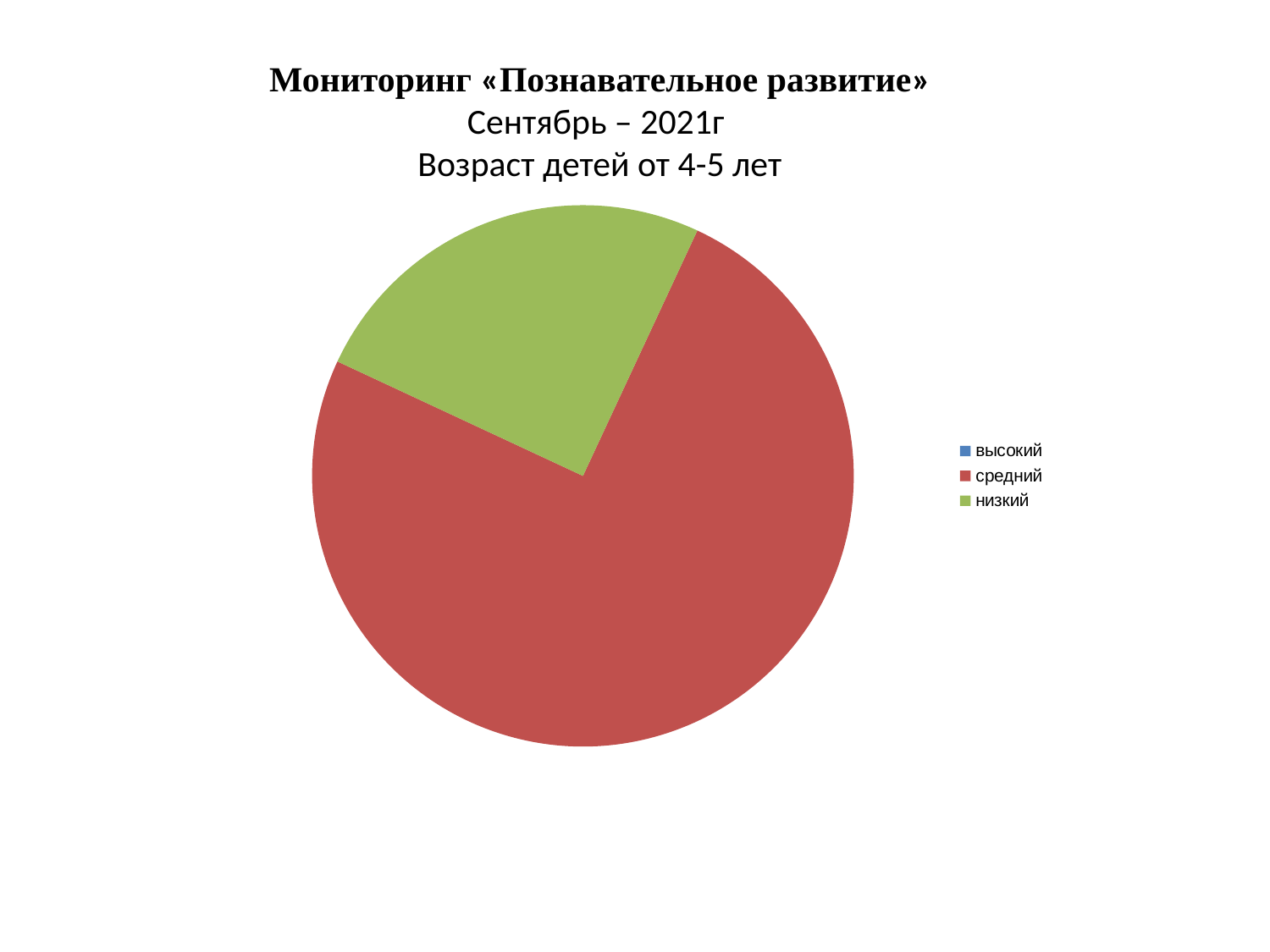
Which category has the largest slice of the pie? средний Is the slice for средний larger or smaller than the slice for низкий? larger Which of the visible slices is smaller, средний or низкий? низкий How many entries does the legend list? 3 How many slices are visible in the pie? 2 What kind of chart is shown on the slide? pie chart What is the title of the chart? Мониторинг «Познавательное развитие» Does the slice for средний take up more or less than half of the pie? more What colour is the slice for низкий? green Which legend category has no visible slice in the pie? высокий